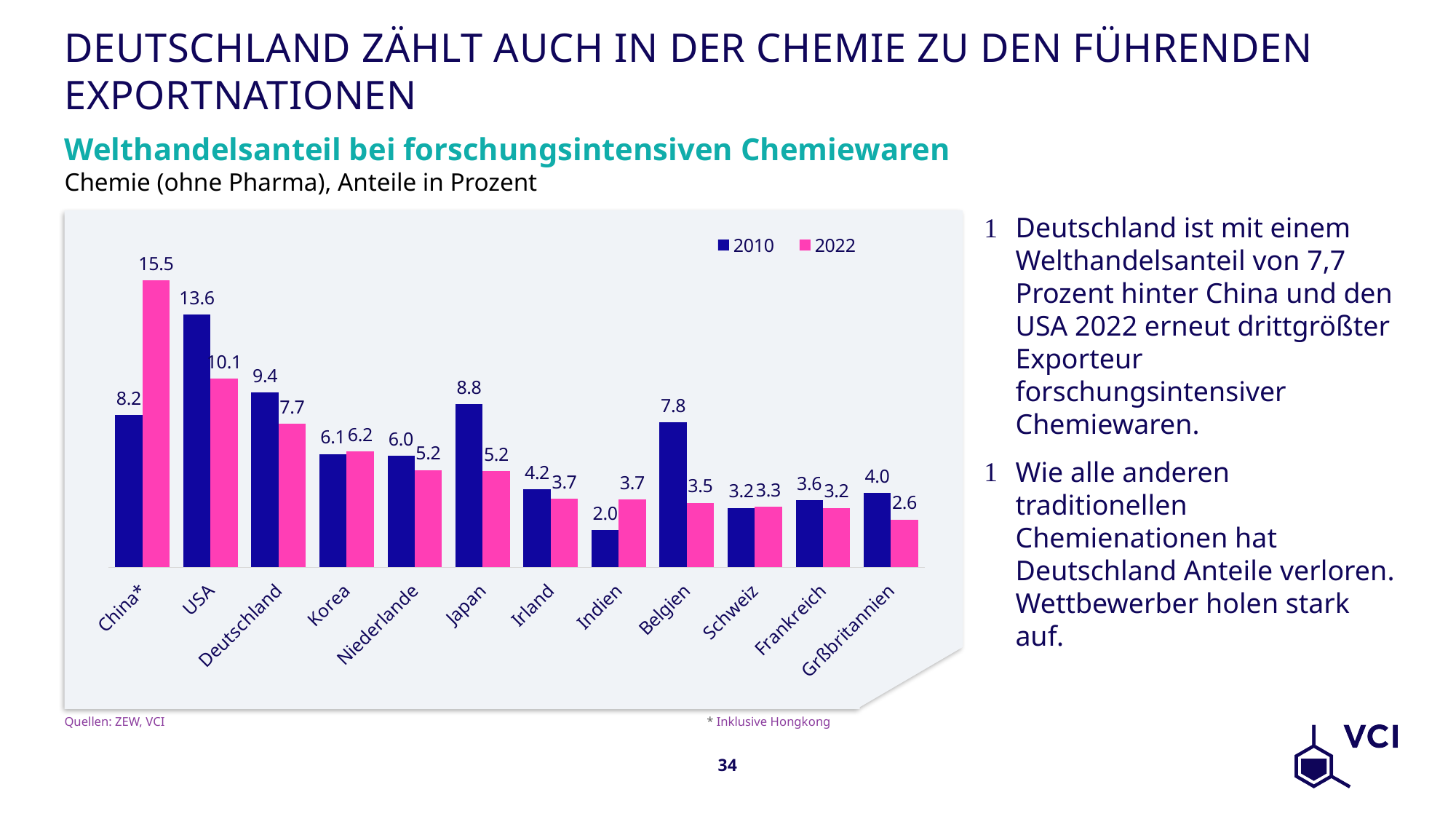
Which country has the highest 2022 value? China* What kind of chart is shown? bar chart What is the difference between the 2022 values for China* and Deutschland? 7.8 What is the 2010 value for Japan? 8.8 What is the 2022 value for Deutschland? 7.7 What is the 2022 value for Indien? 3.7 How many series does the legend list? 2 Which country has the lowest 2010 value? Indien Which colour represents the 2022 series? pink How many countries are shown on the x axis? 12 Which is larger, the 2010 value for Belgien or the 2010 value for Japan? Japan What is the difference between the 2010 and 2022 values for USA? 3.5